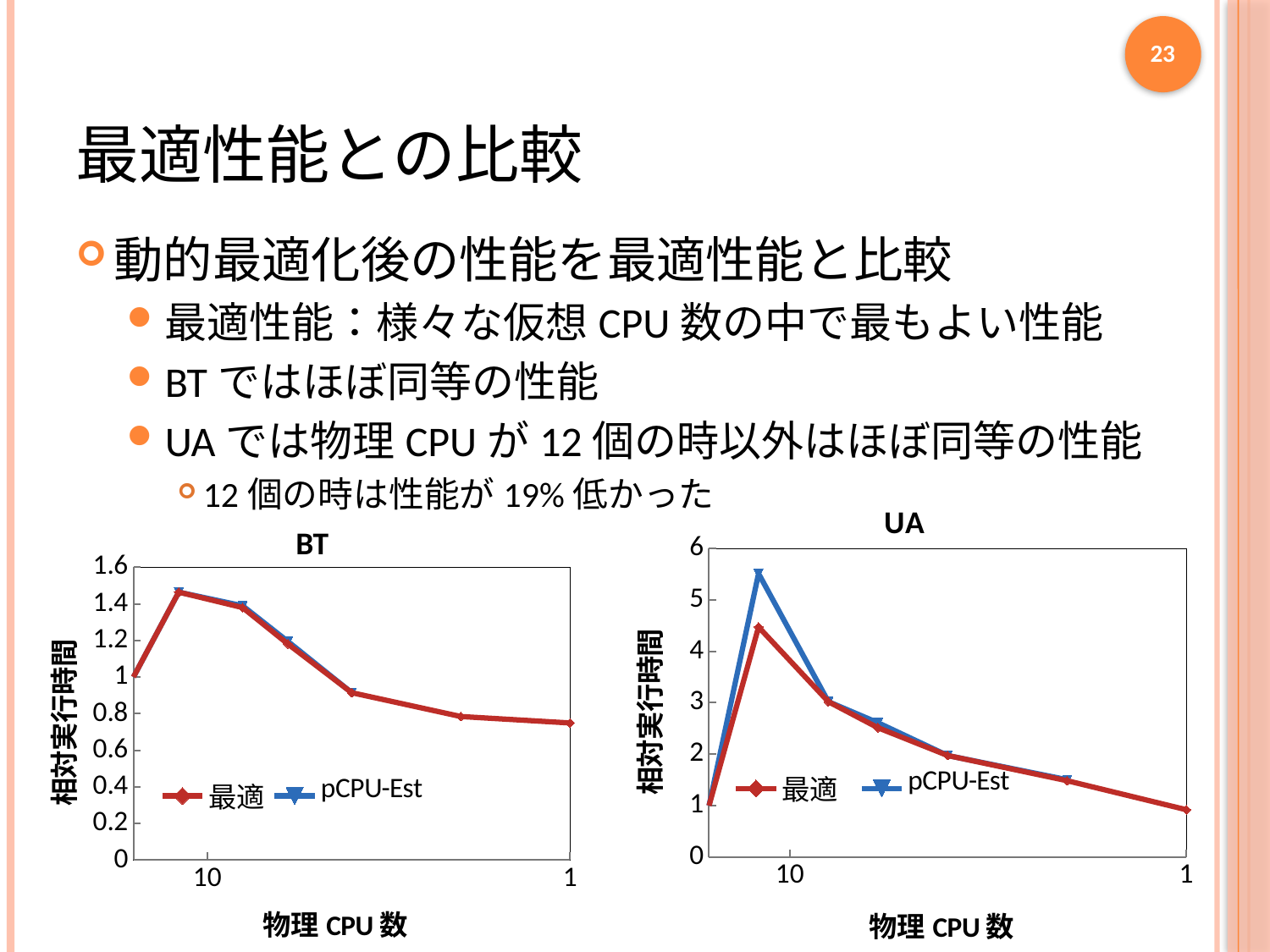
What is the y-axis title of the UA chart? 相対実行時間 In the BT chart, is the peak value of pCPU-Est greater or less than 1.2? greater In the UA chart, which series reaches the highest value? pCPU-Est In the UA chart, is the value at 1 physical CPU greater or less than 2? less What kind of chart is the BT chart? line chart In the UA chart, is the peak value of pCPU-Est greater or less than 5? greater How many series does the legend of the UA chart list? 2 In the UA chart, at the peak, which series is higher: 最適 or pCPU-Est? pCPU-Est In the BT chart, after the peak, do the values rise or fall as the number of physical CPUs decreases toward 1? fall What are the two legend entries in the BT chart? 最適 and pCPU-Est